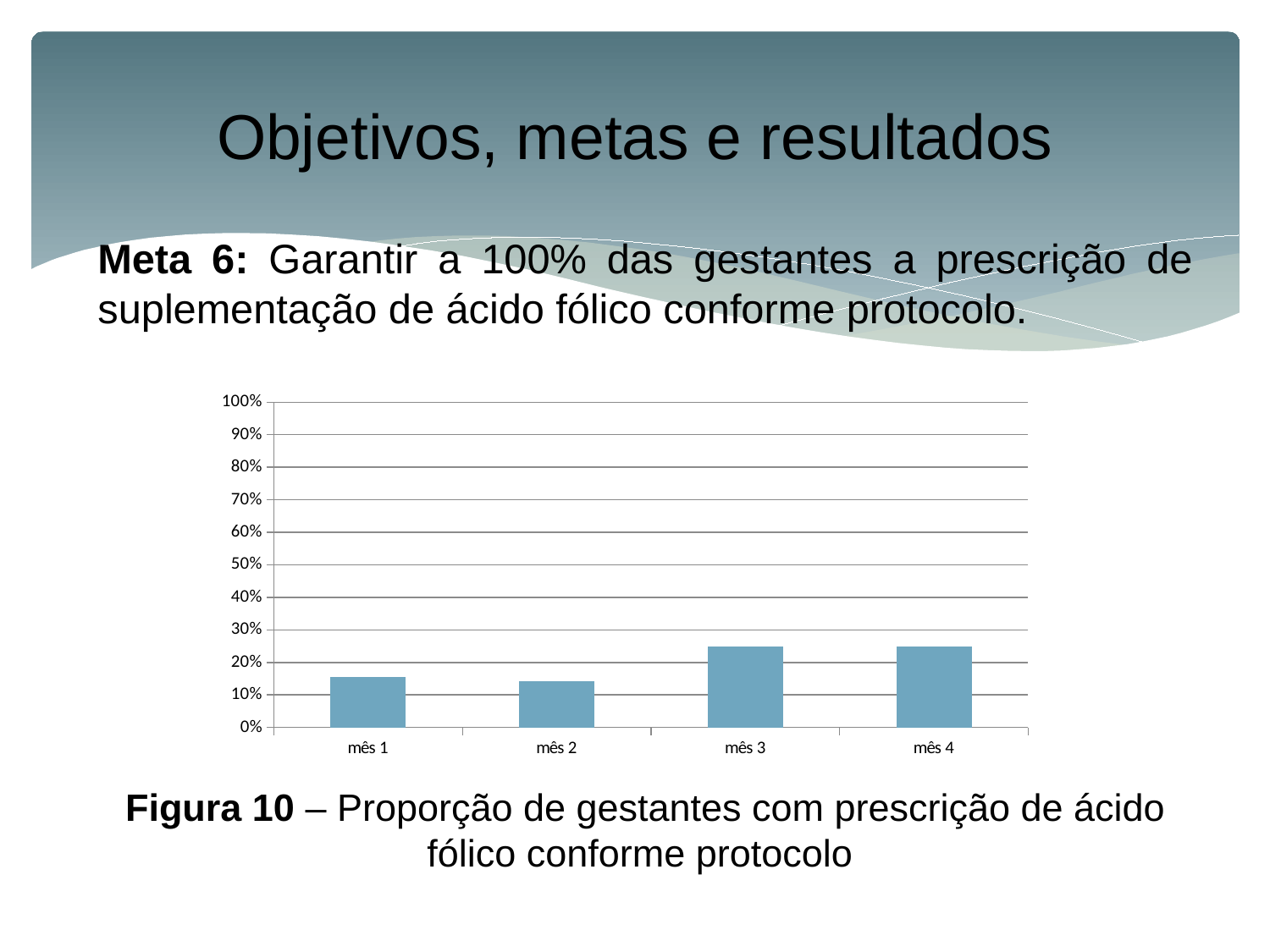
Is the value for mês 3 greater or less than 50%? less Which has the larger value, mês 1 or mês 3? mês 3 How many categories (months) are shown on the x axis of the chart? 4 What is the figure number given in the caption below the chart? Figura 10 Is the value for mês 1 greater or less than 20%? less Do any of the bars in the chart reach the 100% target stated in Meta 6? No What is the highest value shown on the y axis of the chart? 100% What kind of chart is shown on the slide? bar chart Which has the larger value, mês 2 or mês 4? mês 4